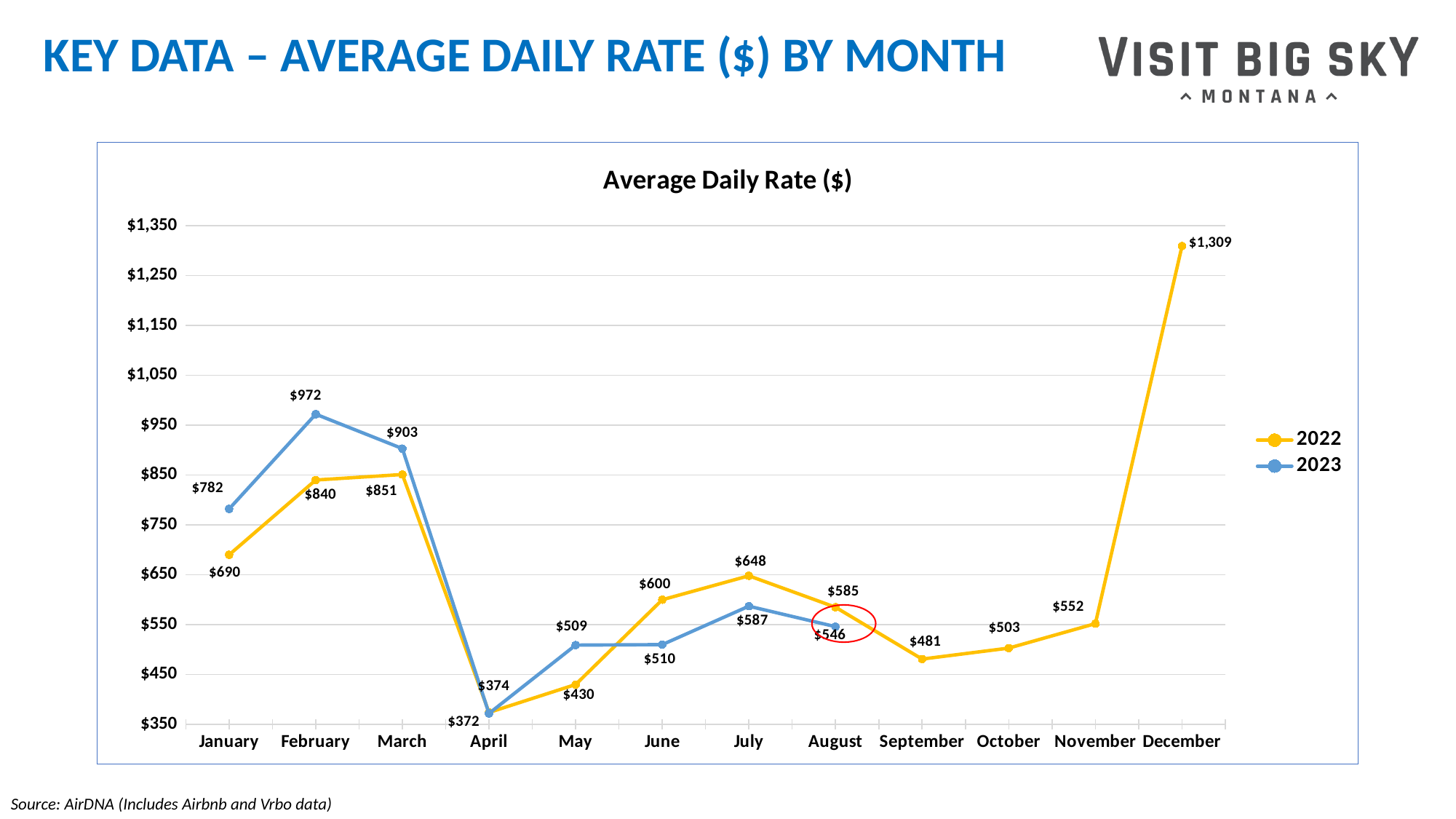
Which is larger, the 2022 or the 2023 average daily rate in June? 2022 Which month has the highest average daily rate for the 2022 series? December What was the average daily rate for 2023 in February? $972 What is the difference between the 2023 and 2022 average daily rates in February? $132 How many series does the legend list? 2 What was the average daily rate for 2022 in December? $1,309 How many months have a plotted value for the 2023 series? 8 What is the title of the chart? Average Daily Rate ($) For the 2022 series, do the values rise or fall from April to July? Rise What was the average daily rate for 2022 in August? $585 What type of chart is shown on the slide? Line chart Which month has the lowest average daily rate for the 2023 series? April